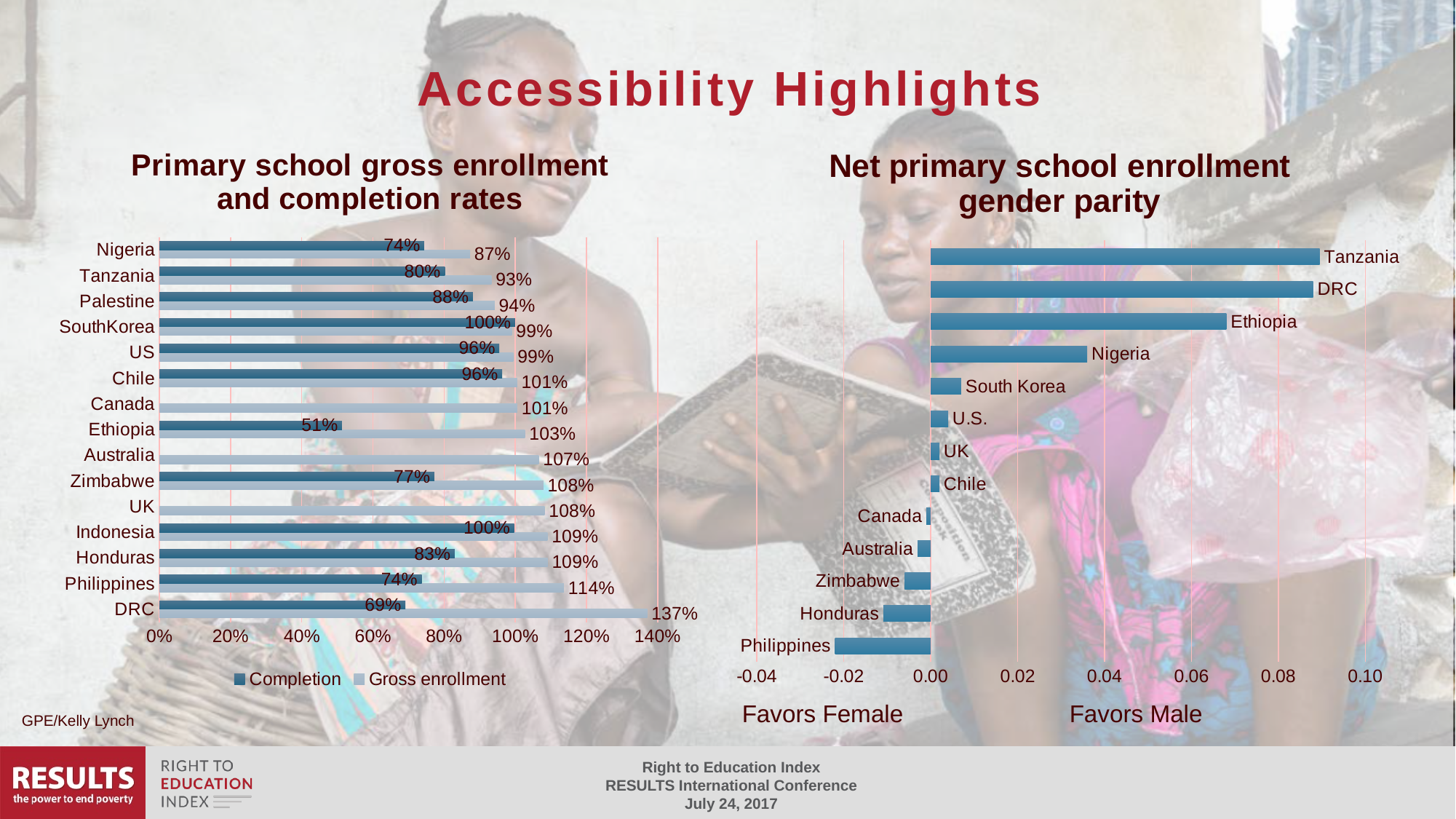
In the 'Primary school gross enrollment and completion rates' chart, what is the completion rate for Ethiopia? 51% How many countries are listed in the 'Primary school gross enrollment and completion rates' chart? 15 In the 'Primary school gross enrollment and completion rates' chart, what is the gross enrollment rate for DRC? 137% In the 'Net primary school enrollment gender parity' chart, what label is shown under the negative side of the axis? Favors Female In the 'Net primary school enrollment gender parity' chart, is the value for Tanzania greater or less than 0.08? greater In the 'Primary school gross enrollment and completion rates' chart, which country has the lowest completion rate? Ethiopia In the 'Primary school gross enrollment and completion rates' chart, which country has the highest gross enrollment rate? DRC In the 'Primary school gross enrollment and completion rates' chart, what is the difference between DRC's gross enrollment rate and its completion rate? 68 percentage points In the 'Primary school gross enrollment and completion rates' chart, which has the higher completion rate, Nigeria or Tanzania? Tanzania What kind of chart is the 'Net primary school enrollment gender parity' chart? Bar chart In the 'Net primary school enrollment gender parity' chart, which country has the lowest value? Philippines How many series does the legend of the 'Primary school gross enrollment and completion rates' chart list? 2